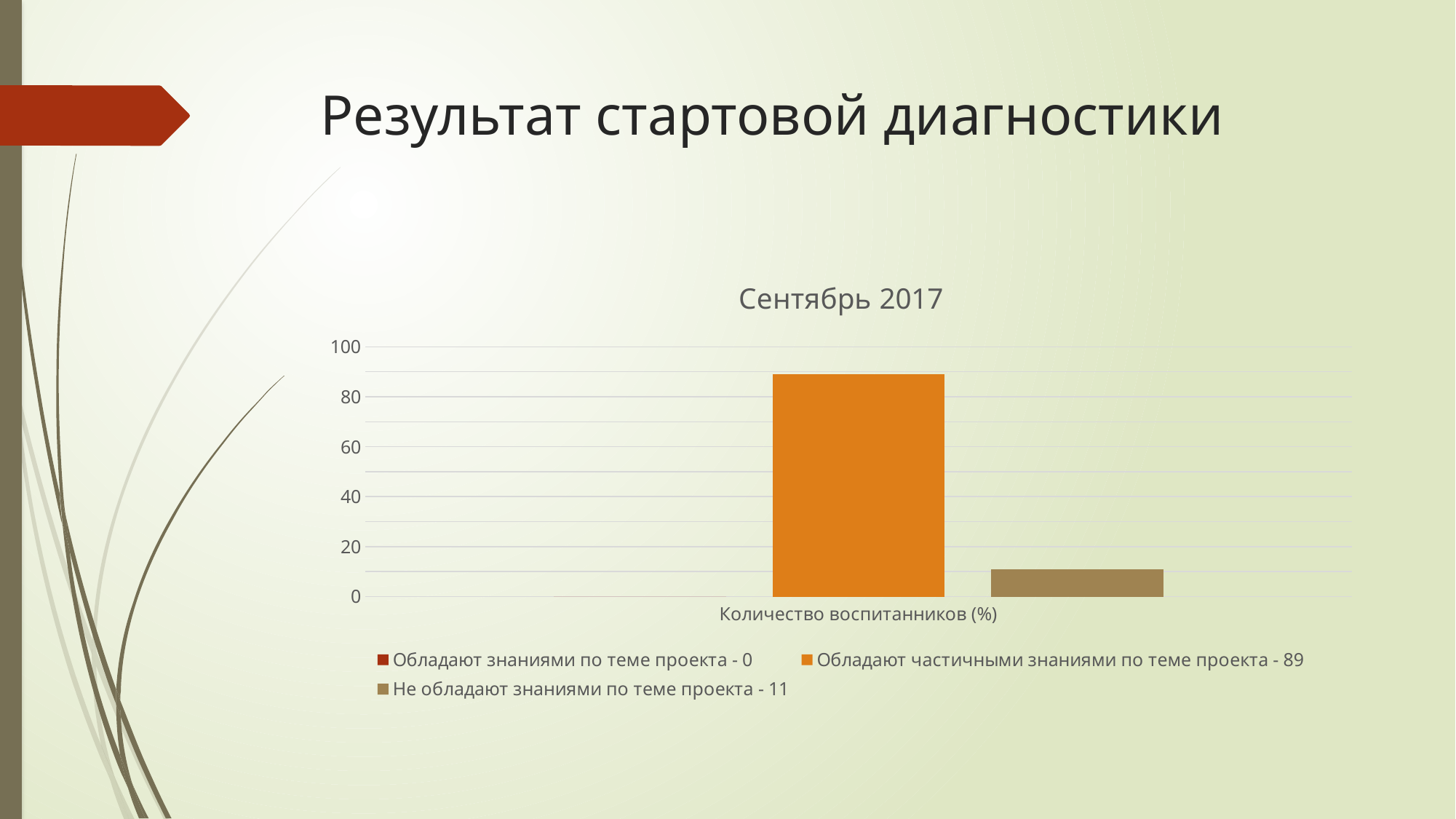
According to the legend, what is the value for 'Обладают частичными знаниями по теме проекта'? 89 Which series has the highest value in the chart? Обладают частичными знаниями по теме проекта What is the title of the chart? Сентябрь 2017 Is the value for 'Обладают частичными знаниями по теме проекта' greater or less than 80? greater According to the legend, what is the value for 'Не обладают знаниями по теме проекта'? 11 What is the difference between the values for 'Обладают частичными знаниями по теме проекта' and 'Не обладают знаниями по теме проекта'? 78 Which series has the lowest value in the chart? Обладают знаниями по теме проекта How many series does the chart legend list? 3 According to the legend, what is the value for 'Обладают знаниями по теме проекта'? 0 What type of chart is shown on the slide? bar chart What is the category label on the x axis of the chart? Количество воспитанников (%) How many categories are shown on the x axis of the chart? 1